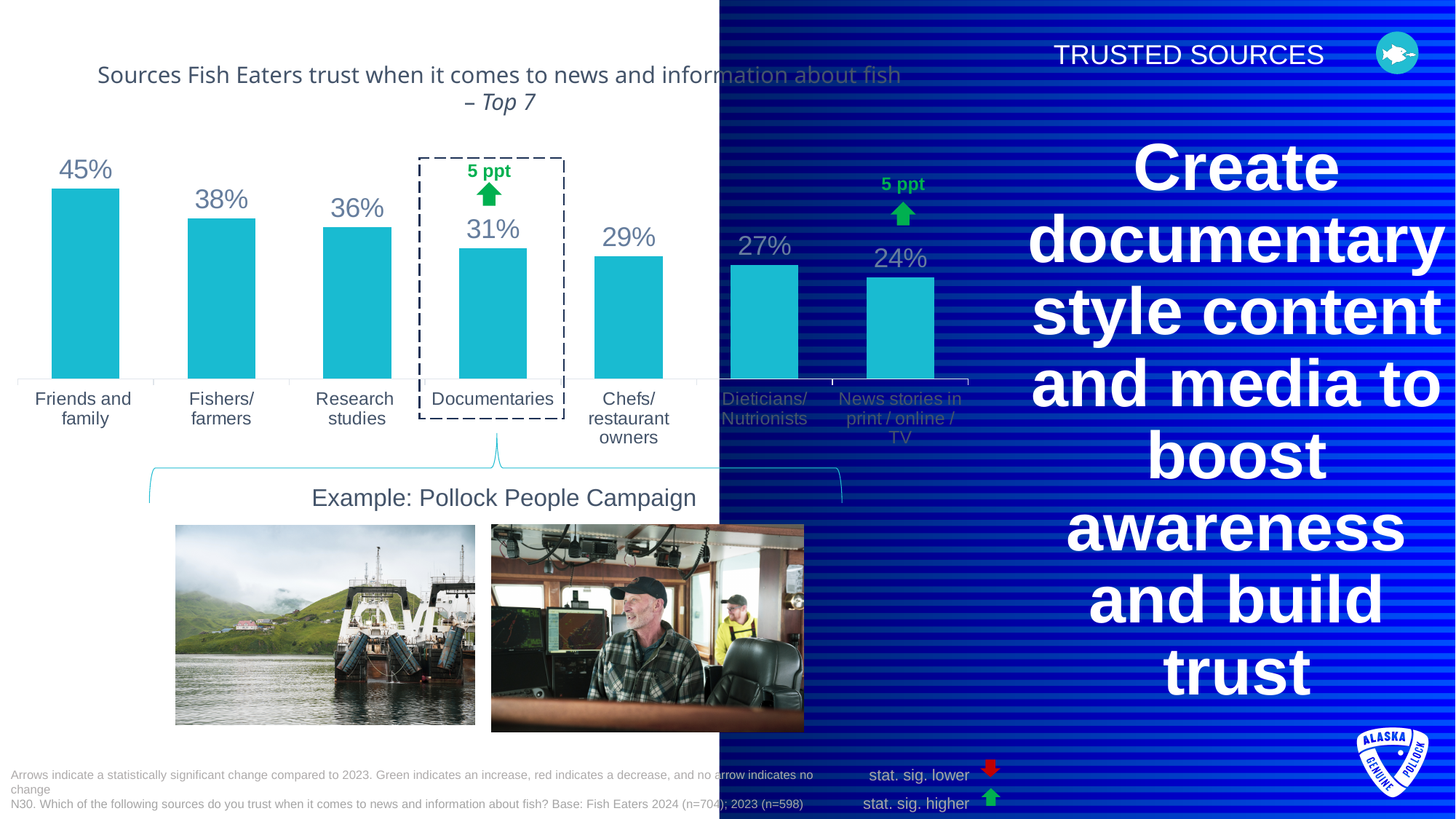
What is the value shown for Research studies? 36% What is the difference in percentage points between Friends and family and Fishers/farmers? 7 What type of chart is used on the slide? Bar chart What is the value shown for Chefs/restaurant owners? 29% By how many percentage points did trust in Documentaries change compared to 2023, according to the green arrow label? 5 ppt What is the value shown for Documentaries? 31% Do the values rise or fall from left to right across the chart? Fall What percentage of Fish Eaters trust friends and family for news and information about fish? 45% Which is larger, the value for Research studies or the value for Documentaries? Research studies How many sources are shown in the chart? 7 Which source has the highest trust percentage? Friends and family Which source has the lowest trust percentage among the seven shown? News stories in print / online / TV